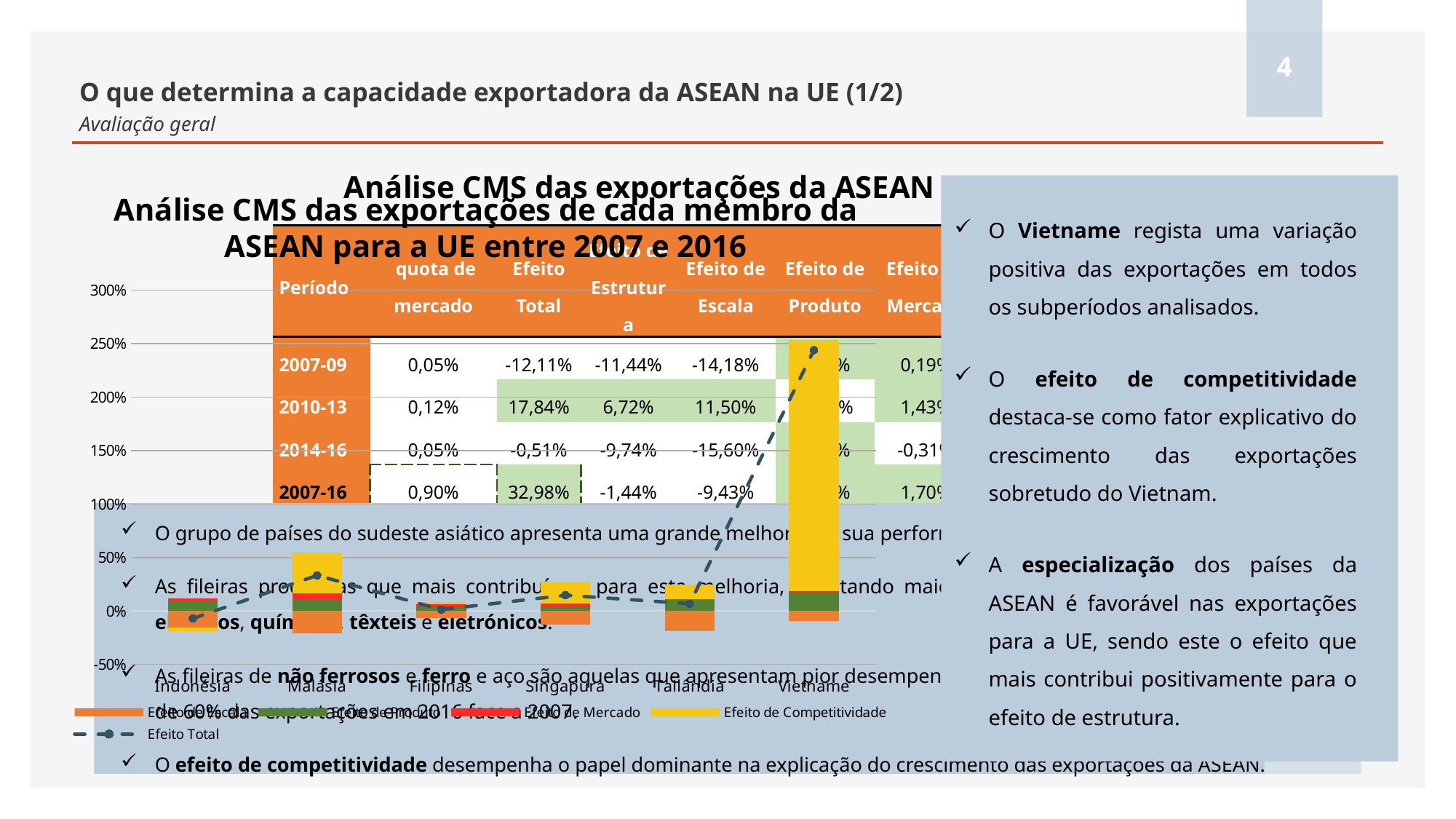
Which series is drawn as a dashed line in the chart? Efeito Total Is the Efeito Total value for Indonésia greater or less than 50%? less Is the Efeito Total value for Vietname greater or less than 200%? greater Which country has the highest Efeito Total in the chart? Vietname How many series does the chart legend list? 5 What colour represents Efeito de Competitividade in the chart legend? yellow How many countries are shown on the x axis of the chart? 6 What kind of chart is shown on the slide? stacked bar chart with a line Which has a larger Efeito Total, Vietname or Malásia? Vietname Is the Efeito Total value for Malásia greater or less than 100%? less Which country has the tallest Efeito de Competitividade bar? Vietname